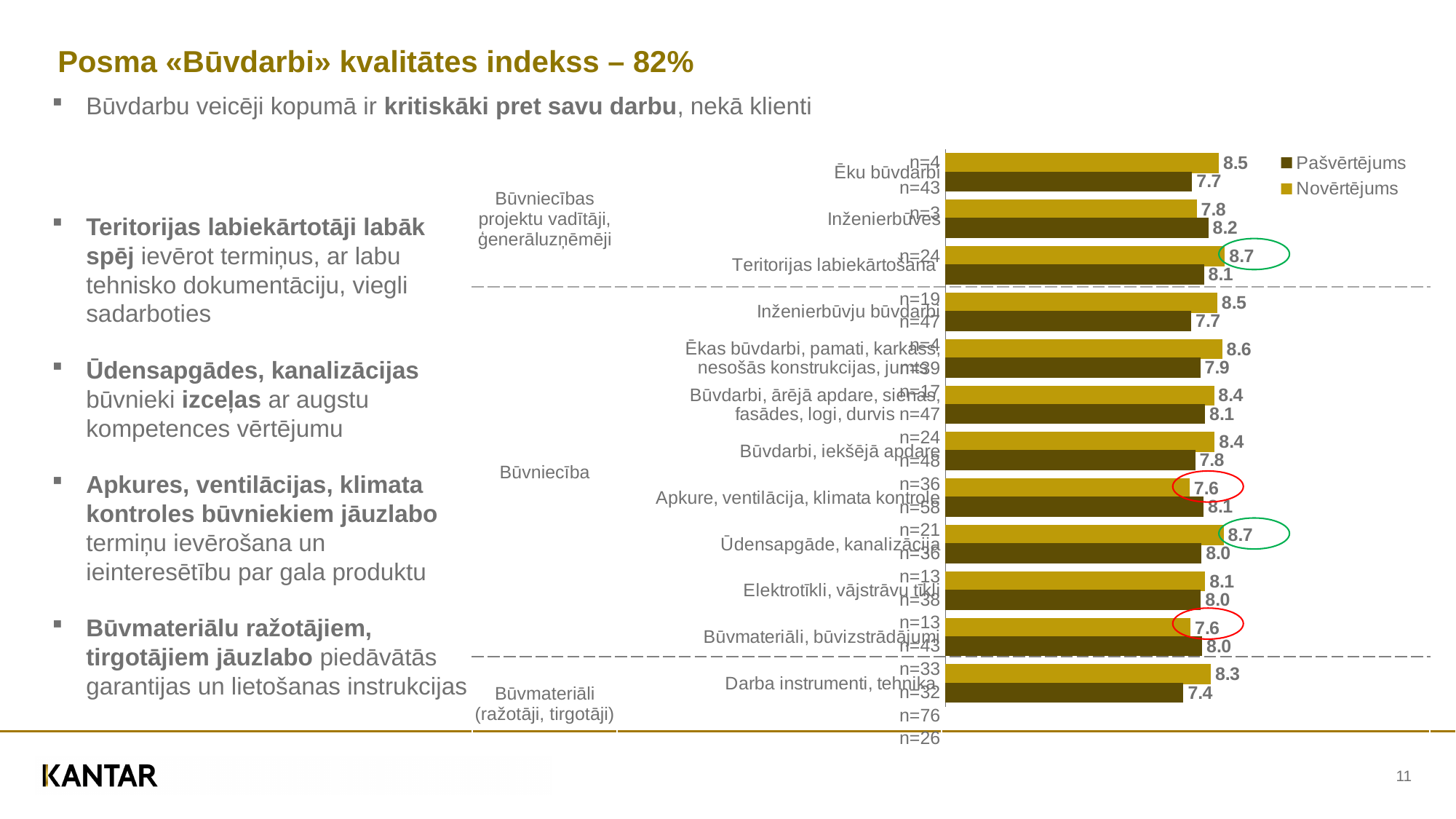
What kind of chart is shown on the slide? bar chart What is the Novērtējums value for Būvmateriāli, būvizstrādājumi? 7.6 What is the difference between the Novērtējums and Pašvērtējums values for Ūdensapgāde, kanalizācija? 0.7 How many series does the chart legend list? 2 For Apkure, ventilācija, klimata kontrole, which is larger: the Pašvērtējums or the Novērtējums value? Pašvērtējums What is the Pašvērtējums value for Inženierbūves? 8.2 Which category has the lowest Pašvērtējums value? Darba instrumenti, tehnika What is the difference between the Novērtējums and Pašvērtējums values for Darba instrumenti, tehnika? 0.9 Which colour represents the Novērtējums series in the chart? gold (yellow) What is the Novērtējums value for Ēku būvdarbi? 8.5 What is the Pašvērtējums value for Darba instrumenti, tehnika? 7.4 How many categories are plotted in the chart? 12